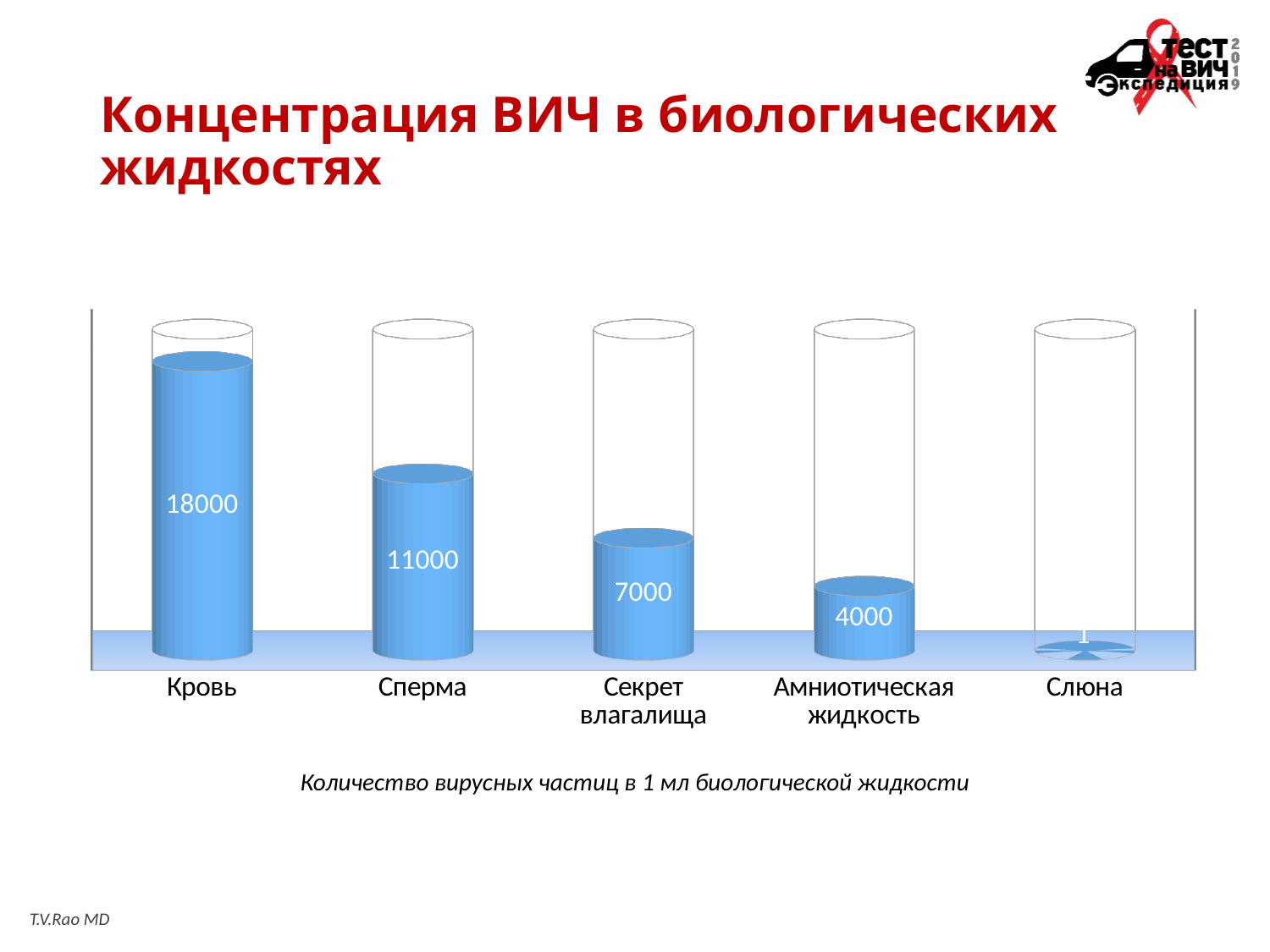
Which category has the highest value? Кровь What is the value shown for Слюна? 1 Which is larger, the value for Сперма or the value for Амниотическая жидкость? Сперма What is the value shown for Кровь? 18000 What is the value shown for Амниотическая жидкость? 4000 Which category has the lowest value? Слюна What is the difference between the values for Кровь and Сперма? 7000 How many categories are shown in the chart? 5 What is the value shown for Секрет влагалища? 7000 Do the values rise or fall from left to right across the categories? fall What is the difference between the values for Секрет влагалища and Амниотическая жидкость? 3000 What is the value shown for Сперма? 11000